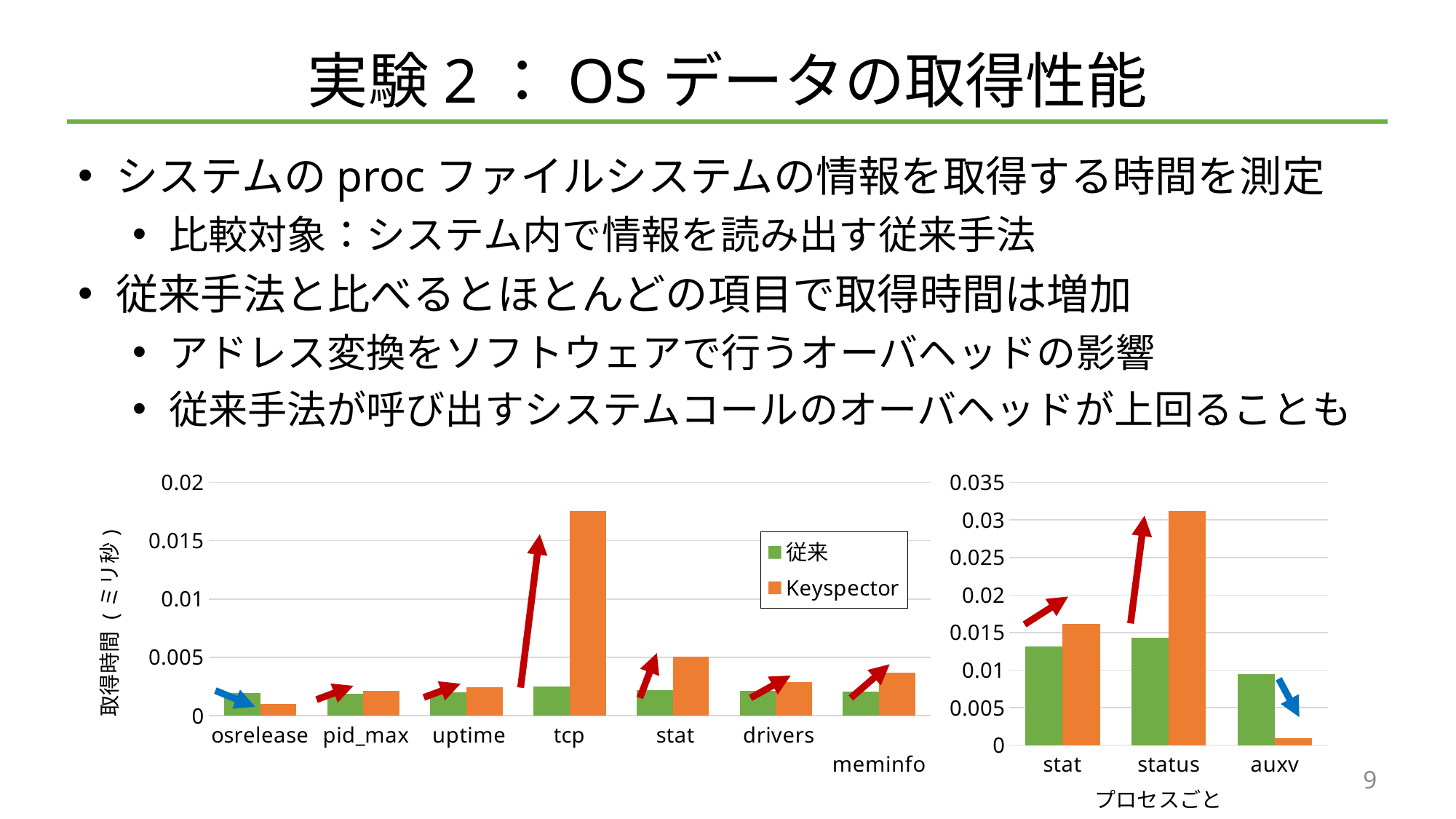
In the left chart, is the Keyspector value for tcp greater or less than 0.015? greater How many categories are shown on the x axis of the right chart (プロセスごと)? 3 How many series does the legend list? 2 In the right chart (プロセスごと), which category has the highest Keyspector value? status How many categories are shown on the x axis of the left chart? 7 What is the y-axis label of the left chart? 取得時間（ミリ秒） In the left chart, which category has the lowest Keyspector value? osrelease In the right chart (プロセスごと), for auxv, which series has the larger value, 従来 or Keyspector? 従来 What kind of chart is the left chart on the slide? bar chart In the left chart, for osrelease, which series has the larger value, 従来 or Keyspector? 従来 In the right chart (プロセスごと), is the Keyspector value for status greater or less than 0.025? greater In the left chart, which category has the highest Keyspector value? tcp